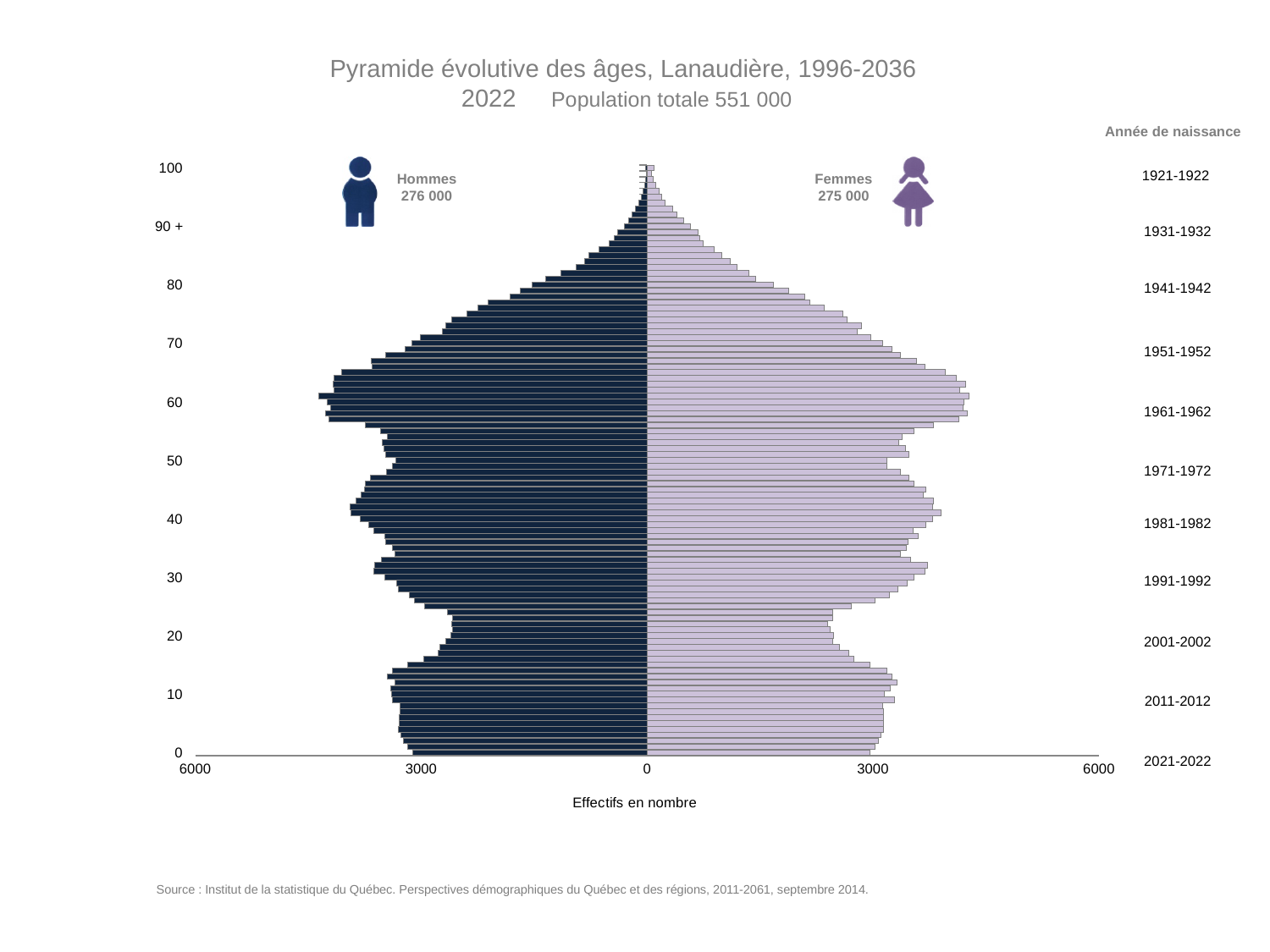
Is the value for men at age 60 greater or less than 3000? greater Is the value for men at age 20 greater or less than 3000? less What kind of chart is shown on the slide? Bar chart (population pyramid) What is the difference between the number of men and the number of women? 1 000 Do the bar lengths rise or fall as age increases from 60 to 100? fall What is the number of men (Hommes) shown on the chart? 276 000 How many series (population groups) does the chart show? 2 What is the total population shown on the slide for 2022? 551 000 What is the number of women (Femmes) shown on the chart? 275 000 Is the value for women at age 90 greater or less than 3000? less What is the label of the horizontal axis? Effectifs en nombre Which group is larger, Hommes or Femmes? Hommes